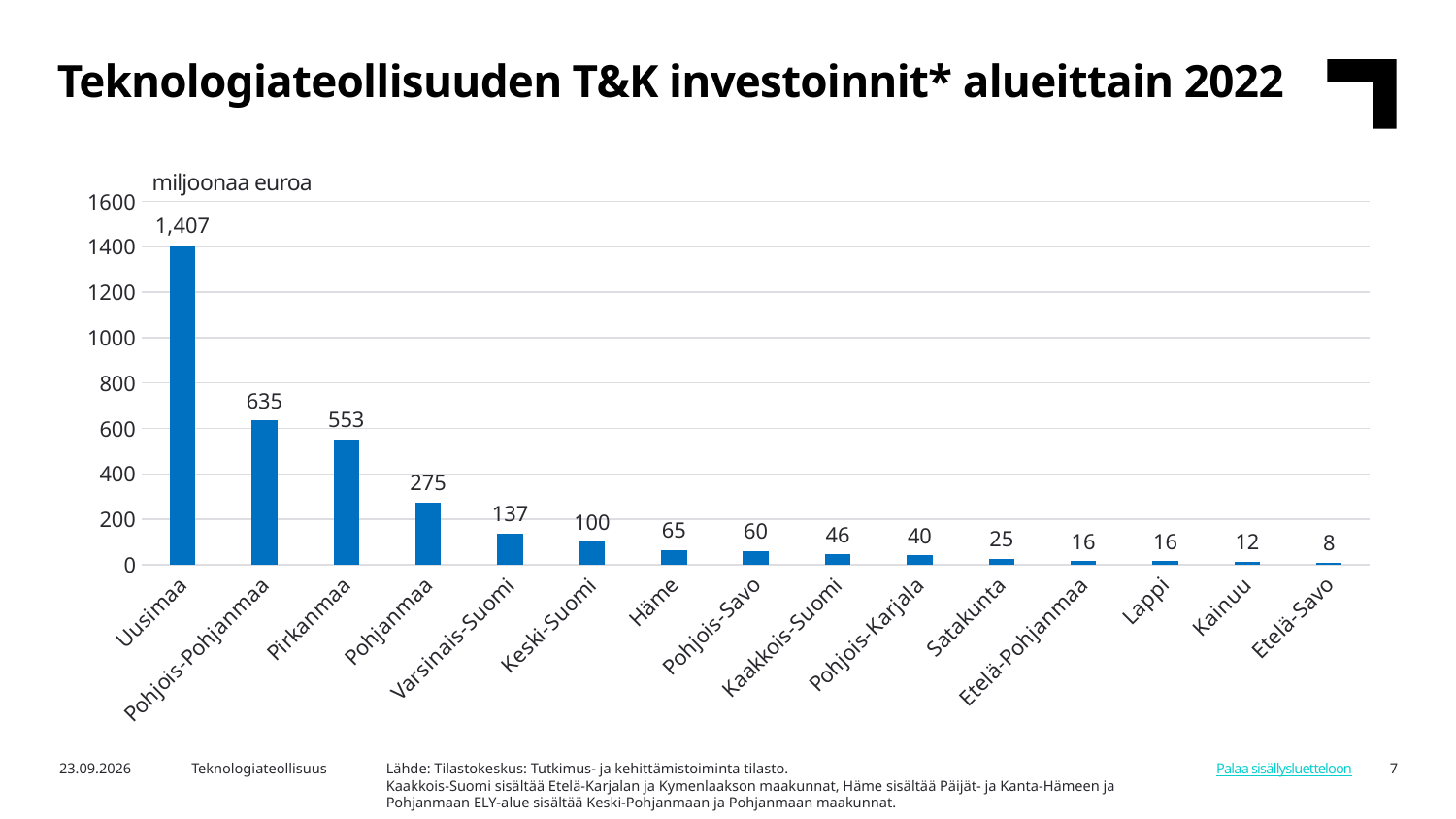
Which is larger, the value for Pohjanmaa or the value for Keski-Suomi? Pohjanmaa What is the value for Satakunta? 25 Which region has the lowest value? Etelä-Savo How many regions are shown in the chart? 15 What unit is shown above the y axis of the chart? miljoonaa euroa What is the value for Varsinais-Suomi? 137 What is the value for Pirkanmaa? 553 What is the value for Uusimaa? 1,407 What is the difference between the values for Pohjois-Pohjanmaa and Pirkanmaa? 82 Which region has the highest value? Uusimaa What kind of chart is shown on the slide? Bar chart Do the values rise or fall from left to right along the x axis? Fall